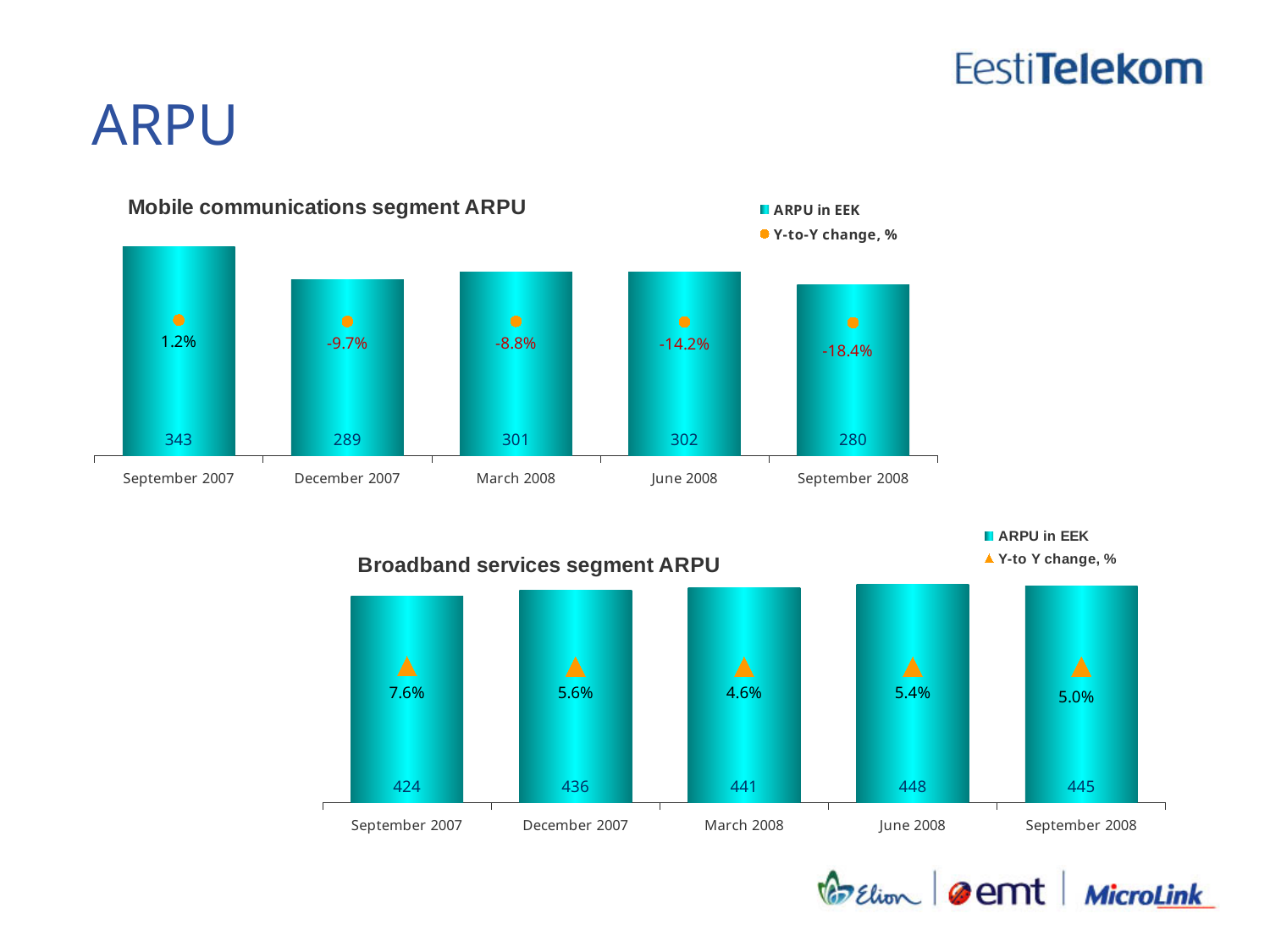
In the Broadband services segment ARPU chart, what is the difference in ARPU in EEK between September 2008 and September 2007? 21 In the Mobile communications segment ARPU chart, how many series does the legend list? 2 What kind of chart is the Broadband services segment ARPU chart? bar chart In the Broadband services segment ARPU chart, which period has the highest ARPU in EEK? June 2008 In the Broadband services segment ARPU chart, what is the ARPU in EEK for June 2008? 448 In the Mobile communications segment ARPU chart, what is the ARPU in EEK for September 2007? 343 In the Broadband services segment ARPU chart, is the ARPU in EEK for December 2007 larger or smaller than for March 2008? smaller In the Mobile communications segment ARPU chart, what is the difference in ARPU in EEK between September 2007 and December 2007? 54 In the Broadband services segment ARPU chart, what is the Y-to-Y change for March 2008? 4.6% In the Mobile communications segment ARPU chart, what is the Y-to-Y change for September 2008? -18.4% In the Mobile communications segment ARPU chart, which period has the lowest ARPU in EEK? September 2008 In the Mobile communications segment ARPU chart, how many periods are shown on the x axis? 5